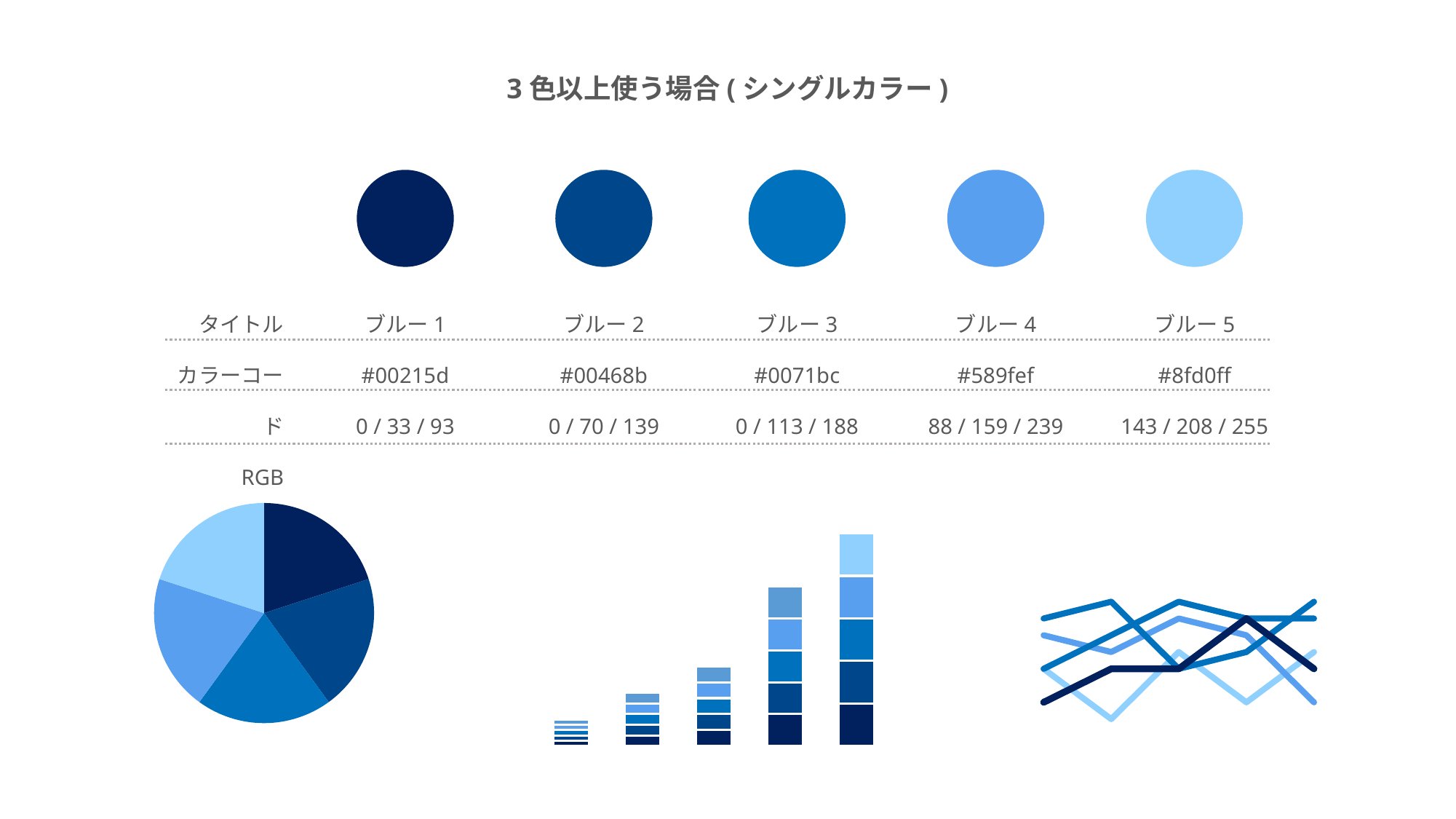
In the bar chart at the bottom centre, how many coloured segments make up each bar? 5 How many colours does the palette above the charts contain? 5 In the bar chart at the bottom centre, which is taller, the leftmost bar or the rightmost bar? The rightmost bar What kind of chart is shown at the bottom left of the slide? Pie chart What kind of chart is shown at the bottom centre of the slide? Bar chart In the bar chart at the bottom centre, do the bar heights rise or fall from left to right? Rise In the pie chart at the bottom left, how many slices are there? 5 In the line chart at the bottom right, how many lines are plotted? 5 What kind of chart is shown at the bottom right of the slide? Line chart In the bar chart at the bottom centre, which bar is the shortest? The leftmost (first) bar In the bar chart at the bottom centre, how many bars are there? 5 In the bar chart at the bottom centre, which bar is the tallest? The rightmost (fifth) bar